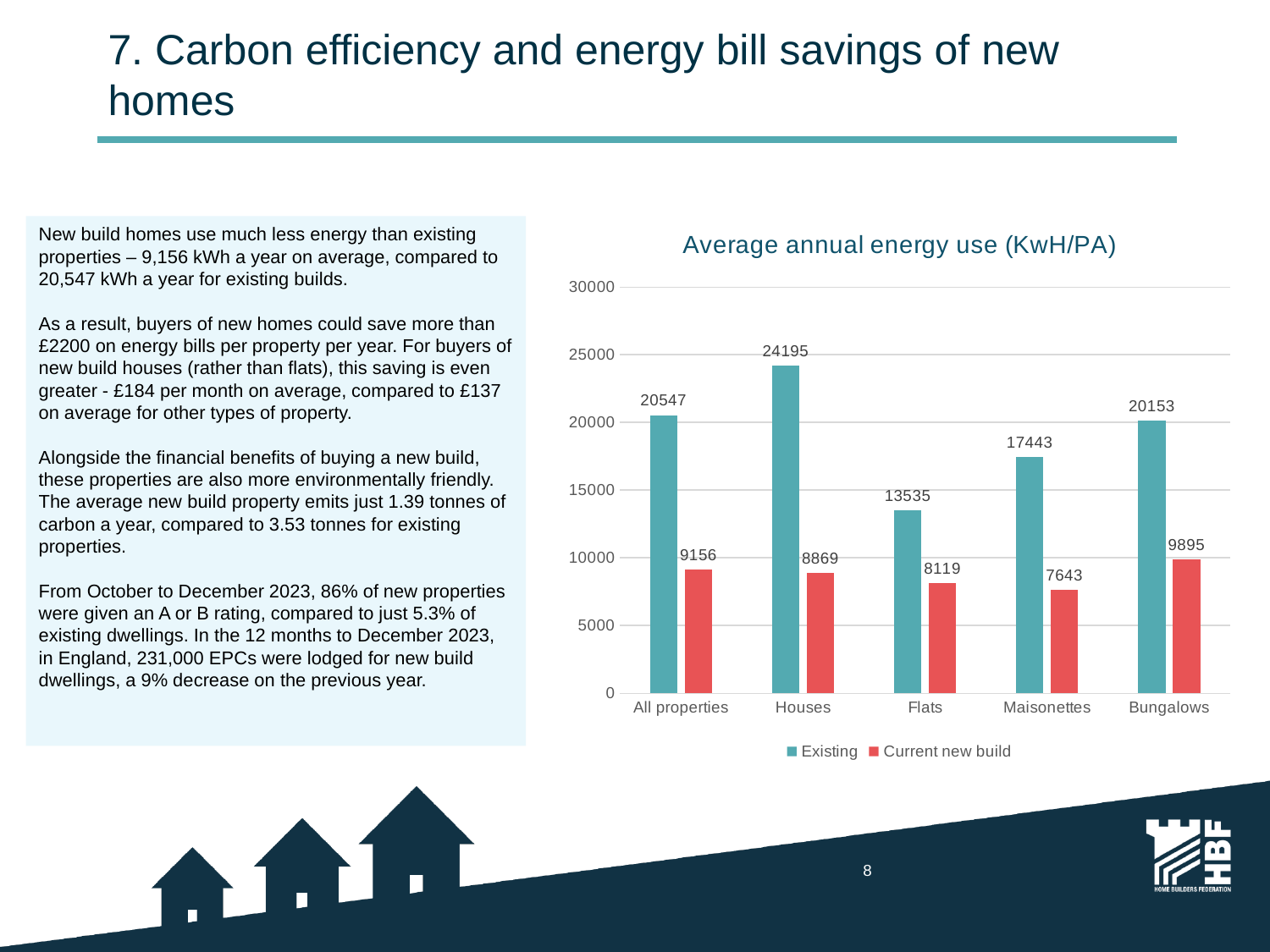
Which is larger: the Current new build value for Bungalows or for Houses? Bungalows What is the title of the chart? Average annual energy use (KwH/PA) What is the difference between the Existing and Current new build values for All properties? 11391 What is the Existing value for Houses? 24195 How many series does the legend list? 2 What kind of chart is shown? bar chart Which category has the highest Existing value? Houses Is the Existing value for Flats greater or less than 15000? less How many categories are shown on the x axis? 5 What is the Existing value for Maisonettes? 17443 What is the Current new build value for Flats? 8119 Which category has the lowest Current new build value? Maisonettes